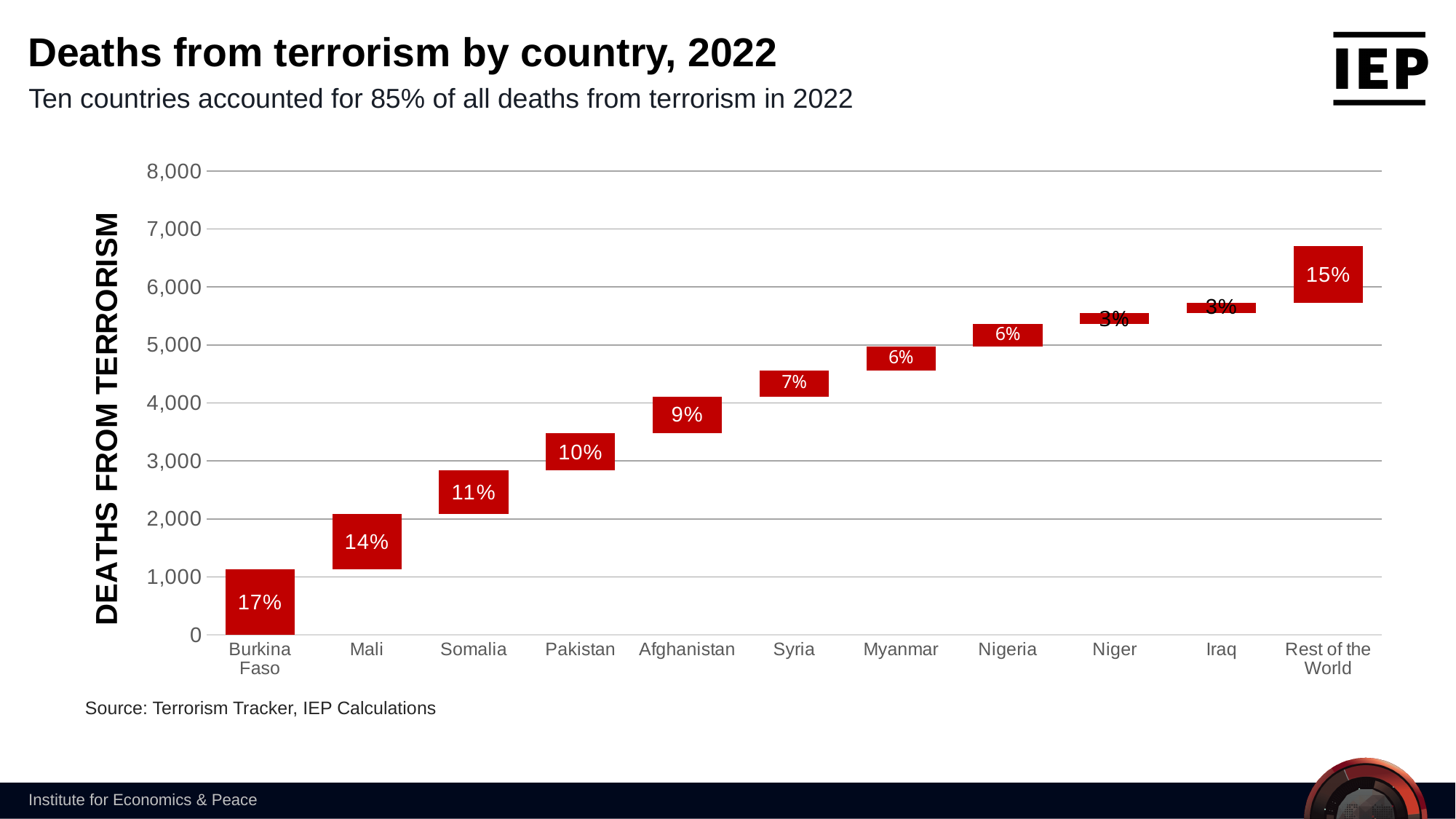
What percentage label is shown for Mali? 14% Which has the larger percentage label, Somalia or Pakistan? Somalia What percentage label is shown for Rest of the World? 15% What is the difference in percentage points between the labels for Burkina Faso and Mali? 3 Is the top of the Rest of the World bar greater or less than 6,000 on the y axis? greater How many categories are shown along the x axis? 11 Which two countries share the lowest percentage label of 3%? Niger and Iraq What is the title of the y axis? DEATHS FROM TERRORISM Which category has the highest percentage label on the chart? Burkina Faso What source is cited below the chart? Terrorism Tracker, IEP Calculations What percentage label is shown for Burkina Faso? 17% What percentage label is shown for Afghanistan? 9%